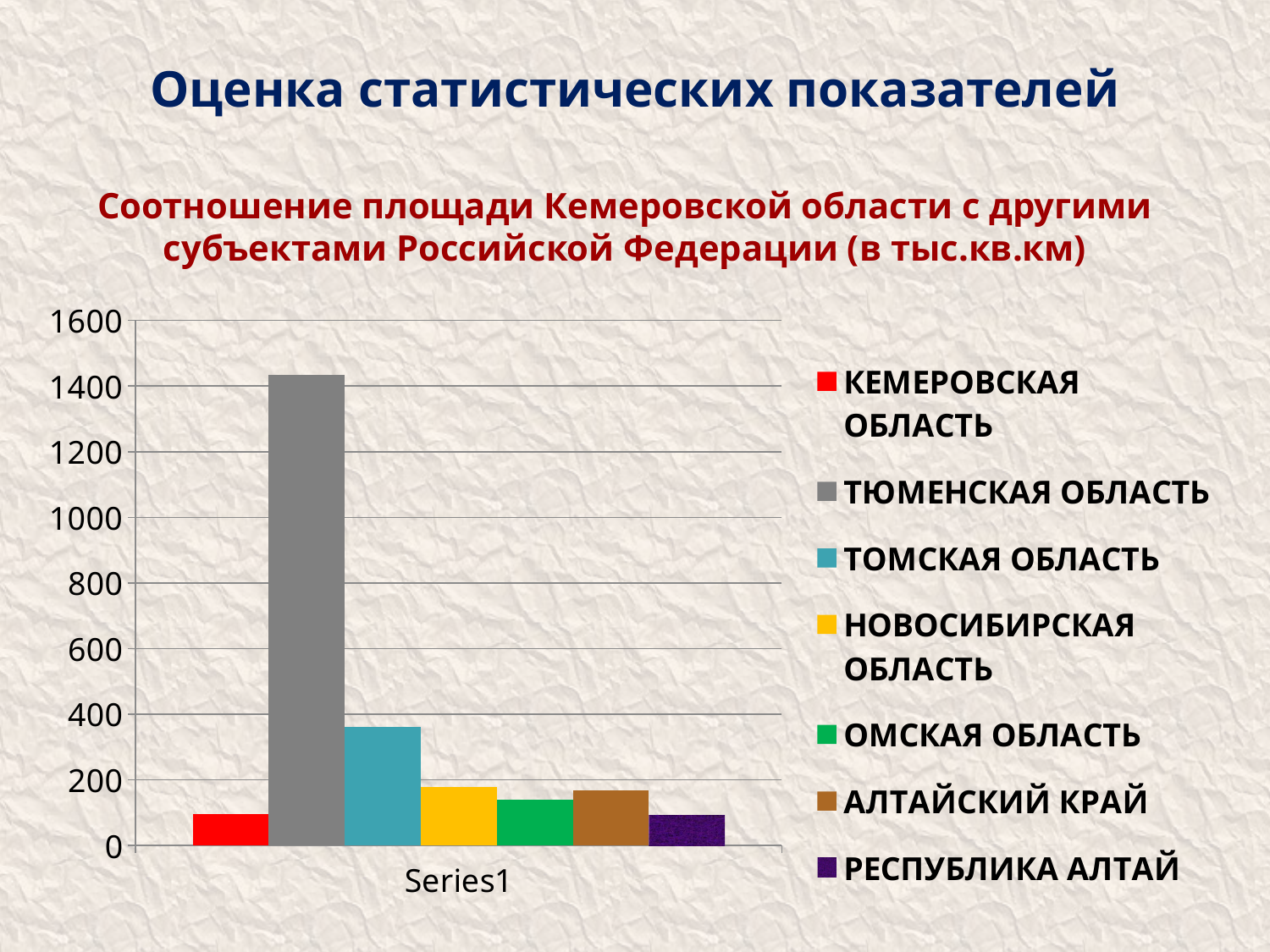
Which region has the highest value in the chart? ТЮМЕНСКАЯ ОБЛАСТЬ Is the value for ТОМСКАЯ ОБЛАСТЬ greater or less than 200? greater Which is larger, the value for ТОМСКАЯ ОБЛАСТЬ or the value for НОВОСИБИРСКАЯ ОБЛАСТЬ? ТОМСКАЯ ОБЛАСТЬ What is the label shown on the x axis of the chart? Series1 Is the value for ТОМСКАЯ ОБЛАСТЬ greater or less than 400? less What kind of chart is shown on the slide? bar chart What colour is the bar for ТЮМЕНСКАЯ ОБЛАСТЬ? grey Is the value for ТЮМЕНСКАЯ ОБЛАСТЬ greater or less than 1200? greater Which is larger, the value for АЛТАЙСКИЙ КРАЙ or the value for ОМСКАЯ ОБЛАСТЬ? АЛТАЙСКИЙ КРАЙ How many series does the legend list? 7